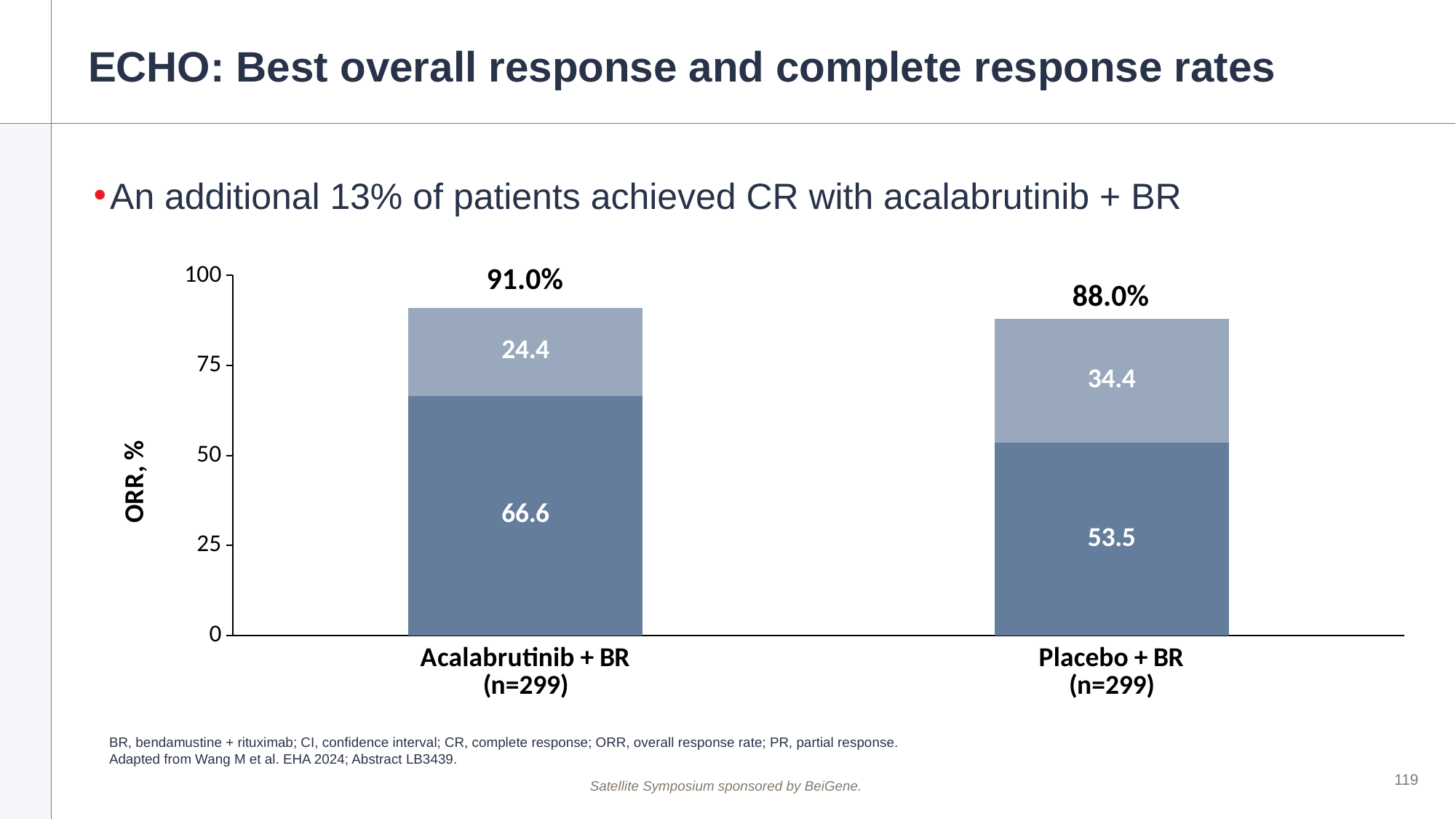
What is the total ORR shown above the Placebo + BR bar? 88.0% What is the value of the top (light) segment of the Placebo + BR bar? 34.4 What type of chart is shown on the slide? Stacked bar chart What is the value of the bottom (dark) segment of the Acalabrutinib + BR bar? 66.6 How many treatment arms (bars) are shown in the chart? 2 What is the difference between the bottom (dark) segment values of the Acalabrutinib + BR and Placebo + BR bars? 13.1 What is the value of the bottom (dark) segment of the Placebo + BR bar? 53.5 What is the label on the y-axis of the chart? ORR, % What is the total ORR shown above the Acalabrutinib + BR bar? 91.0% Which bar has the larger top (light) segment, Acalabrutinib + BR or Placebo + BR? Placebo + BR What is the value of the top (light) segment of the Acalabrutinib + BR bar? 24.4 Which treatment arm has the highest total ORR? Acalabrutinib + BR